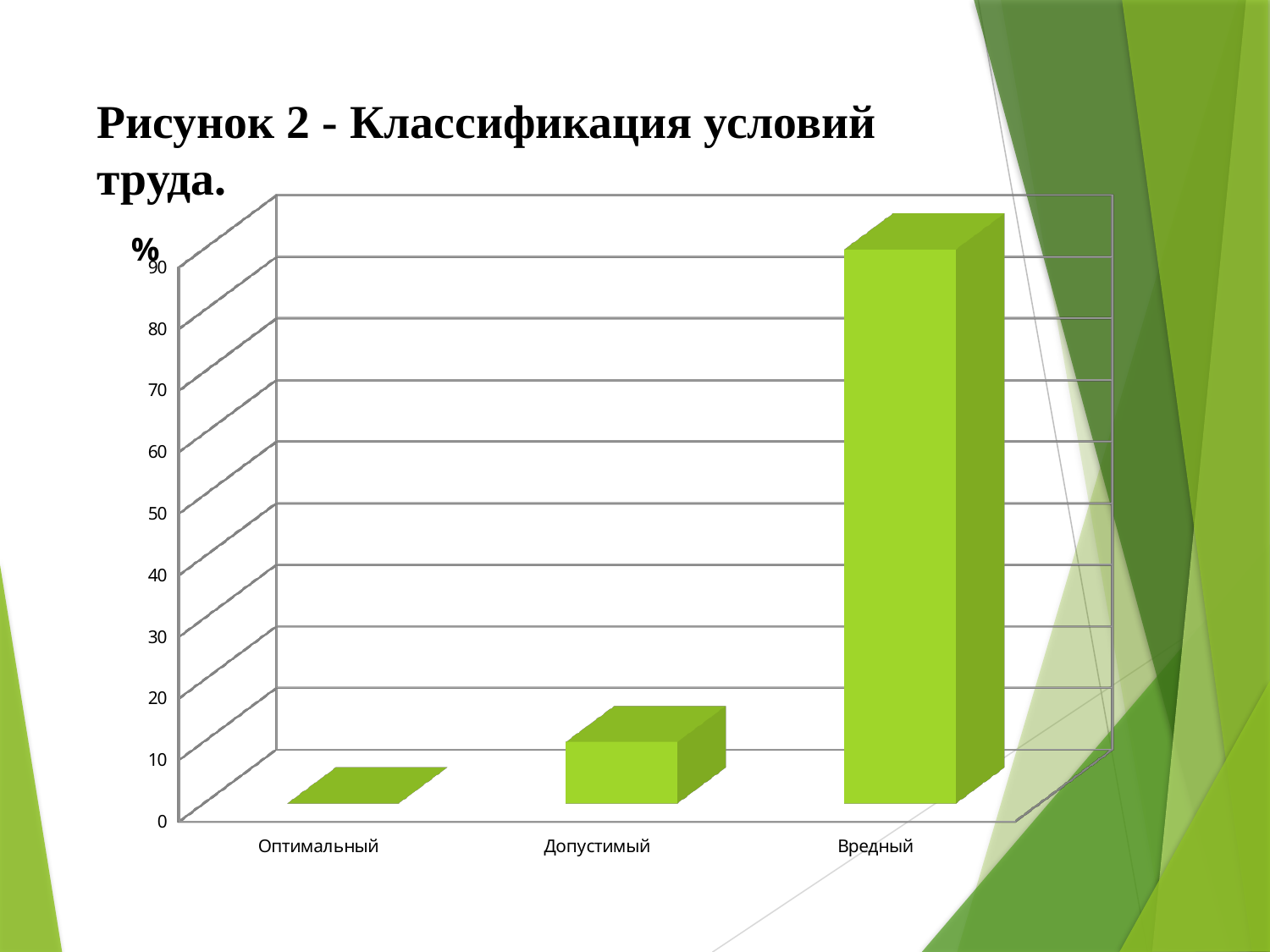
Which is larger, the value for Допустимый or the value for Вредный? Вредный Do the bar values rise or fall from left to right along the x axis? rise Is the value for Оптимальный greater or less than 10? less Which is larger, the value for Оптимальный or the value for Допустимый? Допустимый Is the value for Вредный greater or less than 80? greater How many categories are shown on the x axis of the chart? 3 Is the value for Допустимый greater or less than 20? less Which category has the lowest bar in the chart? Оптимальный What kind of chart is shown on the slide? bar chart What unit is shown on the vertical axis of the chart? % What is the title of the chart on the slide? Рисунок 2 - Классификация условий труда. Which category has the highest bar in the chart? Вредный